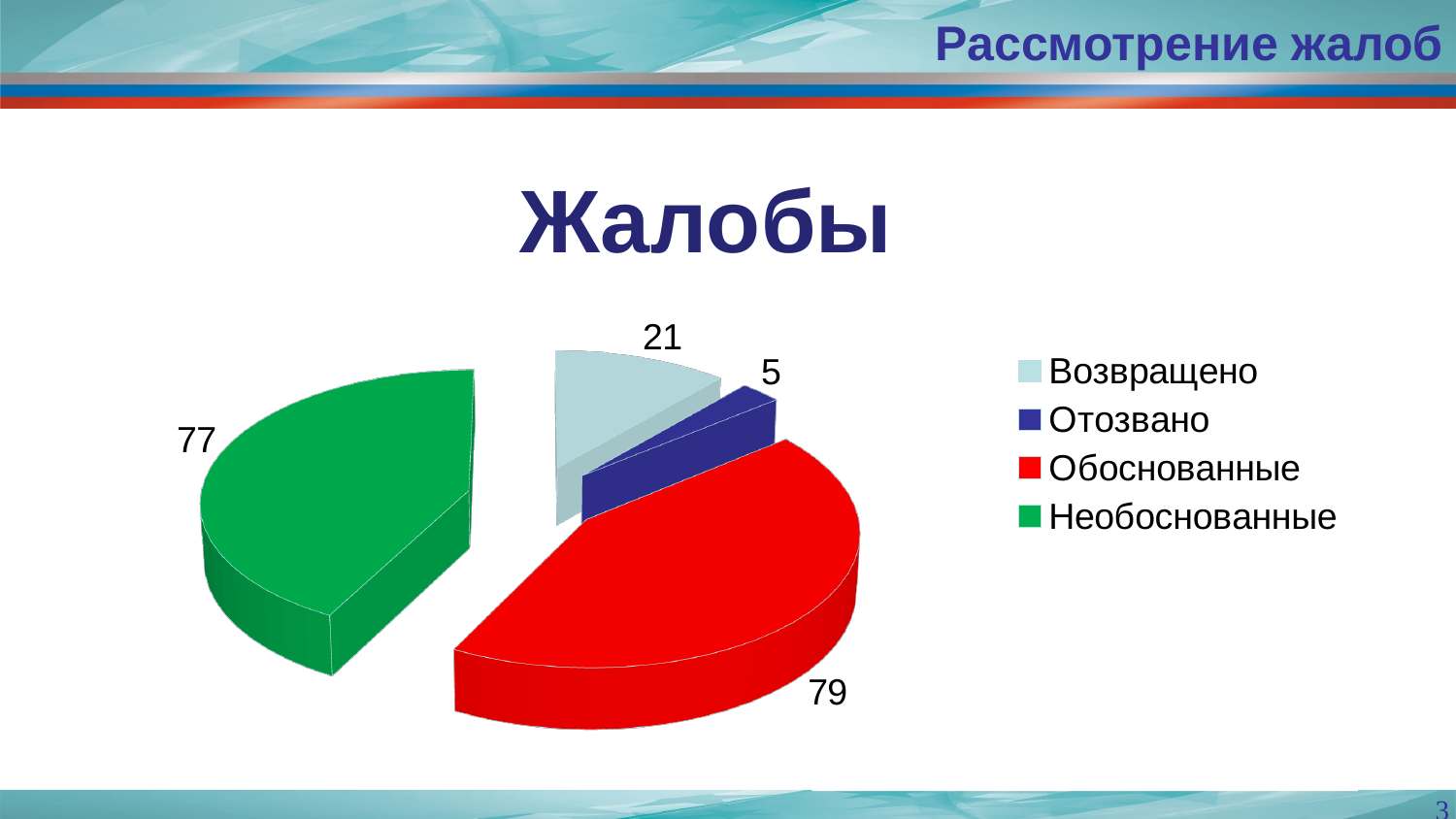
Which is larger, the value for Возвращено or the value for Отозвано? Возвращено What colour is the slice for Необоснованные? Green What is the title of the chart? Жалобы What is the value for Отозвано? 5 What is the value for Обоснованные? 79 Which category has the largest value? Обоснованные What is the value for Необоснованные? 77 What type of chart is shown on the slide? Pie chart What is the value for Возвращено? 21 What is the difference between the values for Обоснованные and Необоснованные? 2 Which category has the smallest value? Отозвано How many categories does the pie chart have? 4